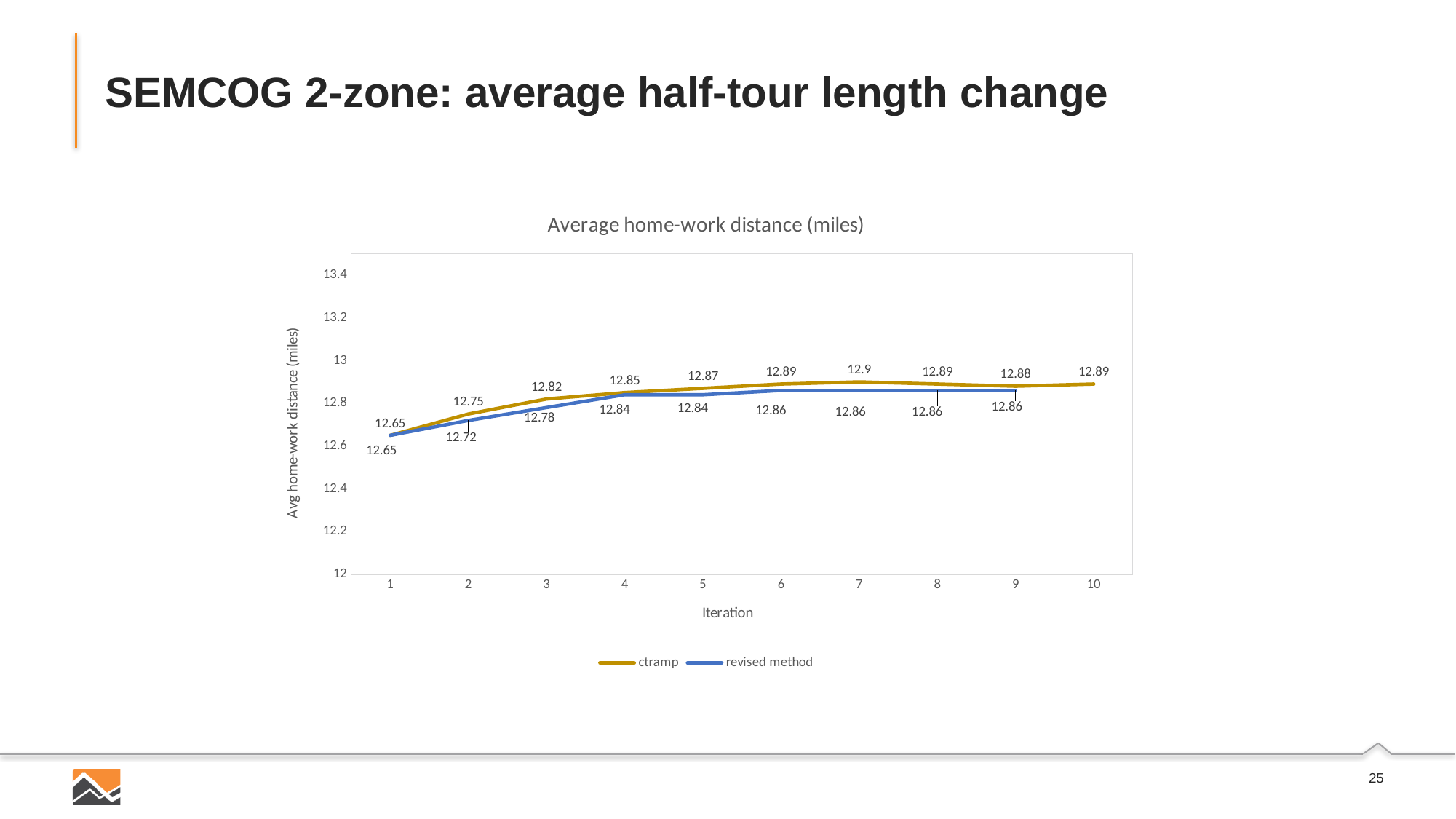
What is the revised method value at iteration 3? 12.78 At which iteration is the ctramp series lowest? 1 What is the title of the chart? Average home-work distance (miles) At which iteration does the ctramp series reach its highest value? 7 What is the ctramp value at iteration 7? 12.9 What kind of chart is shown on the slide? line chart At iteration 3, which series has the larger value, ctramp or revised method? ctramp Does the ctramp series rise or fall from iteration 1 to iteration 7? rise How many iterations are plotted along the x axis? 10 How many series does the legend list? 2 What is the difference between the ctramp and revised method values at iteration 2? 0.03 What is the revised method value at iteration 6? 12.86